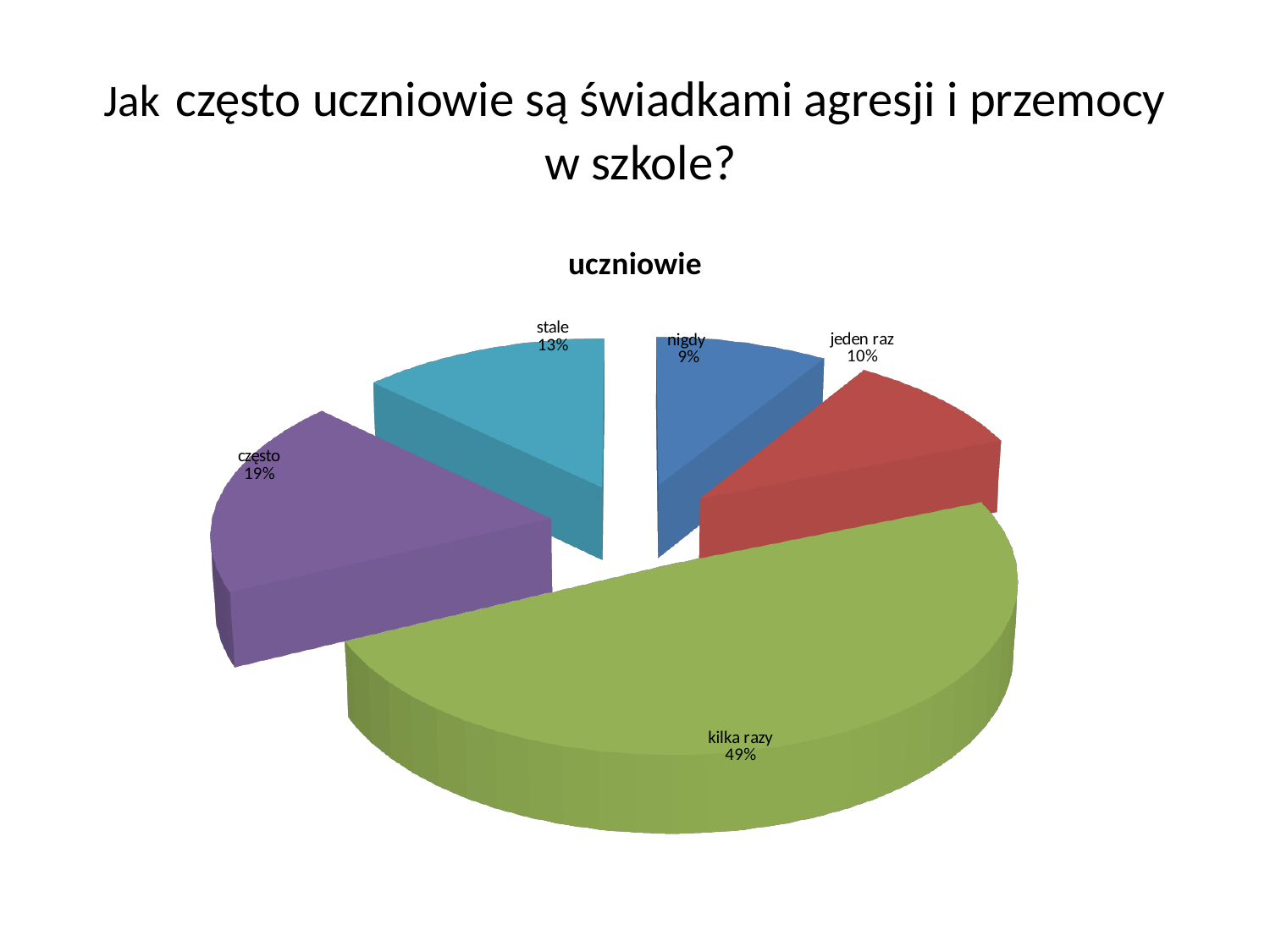
What is the value shown for "nigdy"? 9% Which category has the smallest slice? nigdy What kind of chart is shown on the slide? pie chart Which category has the largest slice? kilka razy What is the difference between the values for "kilka razy" and "często"? 30% What is the value shown for "jeden raz"? 10% Which is larger, the value for "stale" or the value for "jeden raz"? stale What is the value shown for "stale"? 13% What is the value shown for "często"? 19% How many slices does the pie chart have? 5 What share of the pie is labelled "kilka razy"? 49% What is the title of the chart? uczniowie